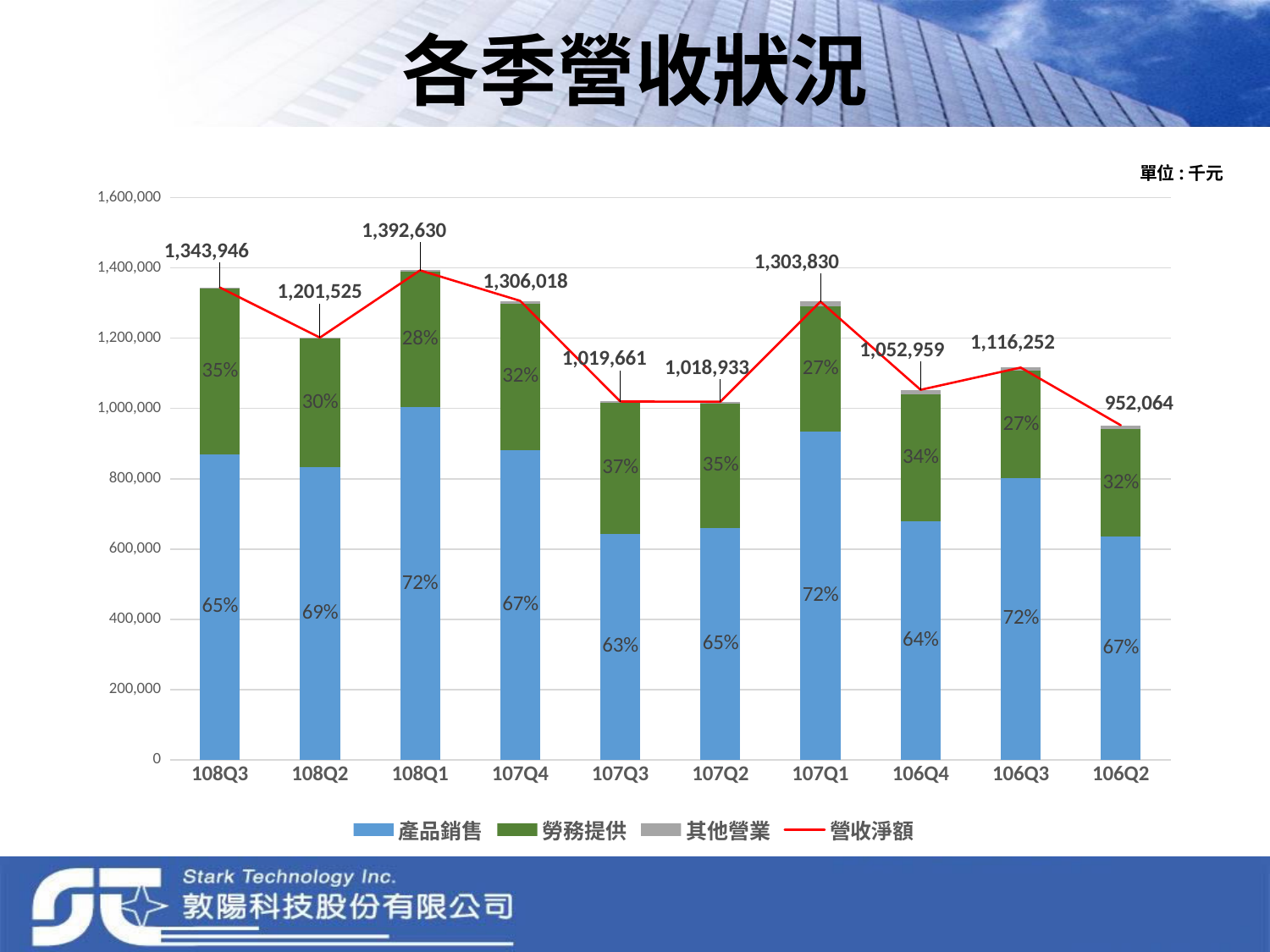
Which quarter has the highest 營收淨額? 108Q1 What percentage share does 勞務提供 have in the 108Q3 bar? 35% How many series does the legend list? 4 What percentage share does 產品銷售 have in the 107Q3 bar? 63% What is the 營收淨額 value for 108Q1? 1,392,630 Which quarter has the lowest 營收淨額? 106Q2 Which quarter has a larger 營收淨額, 107Q1 or 106Q4? 107Q1 Is the 營收淨額 for 106Q3 greater or less than 1,200,000? less What unit is stated for the values in the chart? 千元 What is the difference in 營收淨額 between 108Q1 and 108Q2? 191,105 How many quarters are shown on the x axis? 10 What is the 營收淨額 value for 106Q2? 952,064